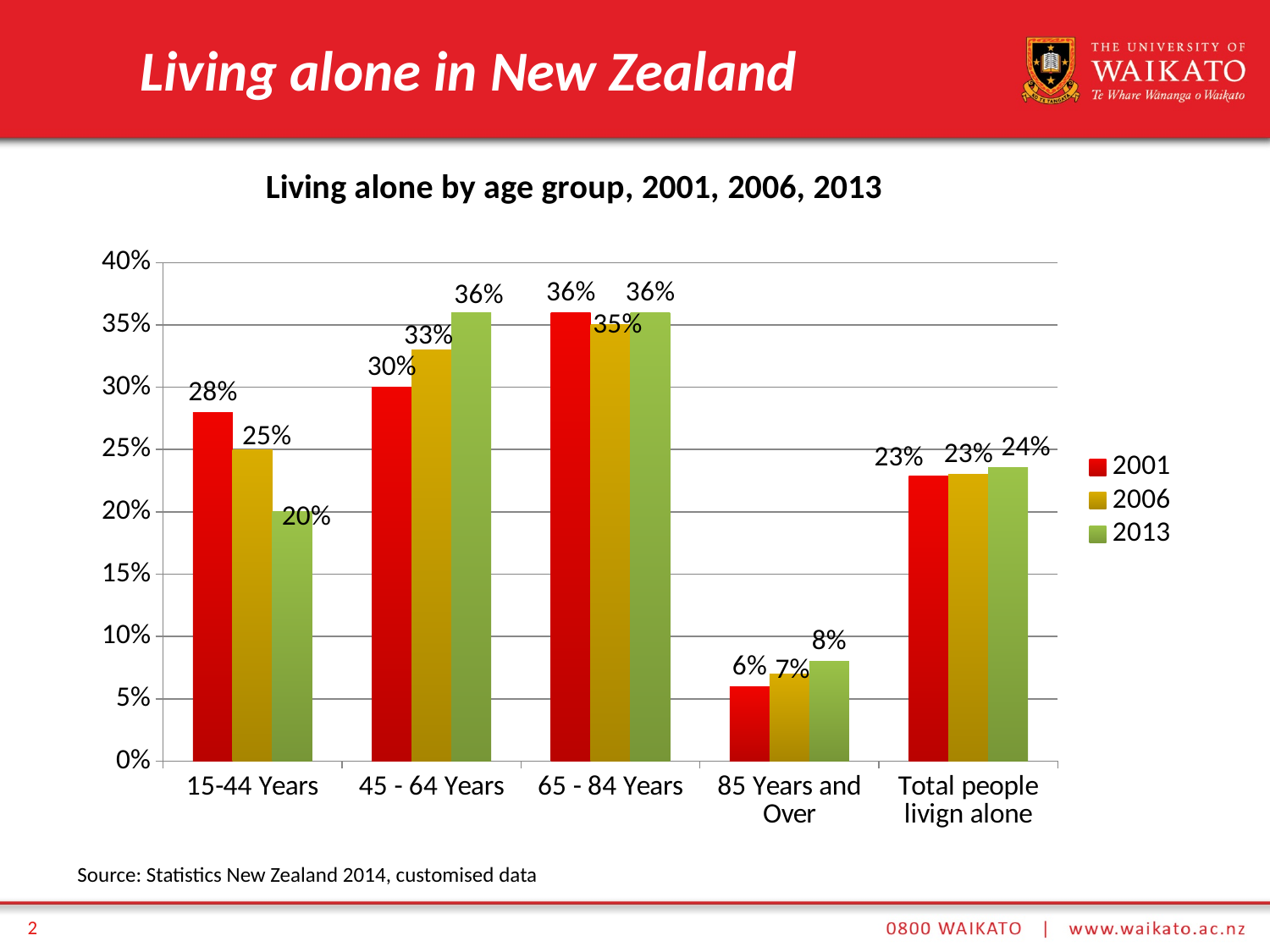
What is the title of the chart? Living alone by age group, 2001, 2006, 2013 How many age group categories are shown on the x axis? 5 Do the values for 15-44 Years rise or fall from 2001 to 2013? Fall Which age group has the lowest value in 2006? 85 Years and Over What is the value for 45 - 64 Years in 2006? 33% What kind of chart is shown? Bar chart How many series does the legend list? 3 What is the value for 15-44 Years in 2001? 28% What is the value for 85 Years and Over in 2013? 8% Which age group has the highest value in 2001? 65 - 84 Years Which is larger for 45 - 64 Years: the 2001 value or the 2013 value? 2013 What is the difference between the 2001 and 2013 values for 15-44 Years? 8%